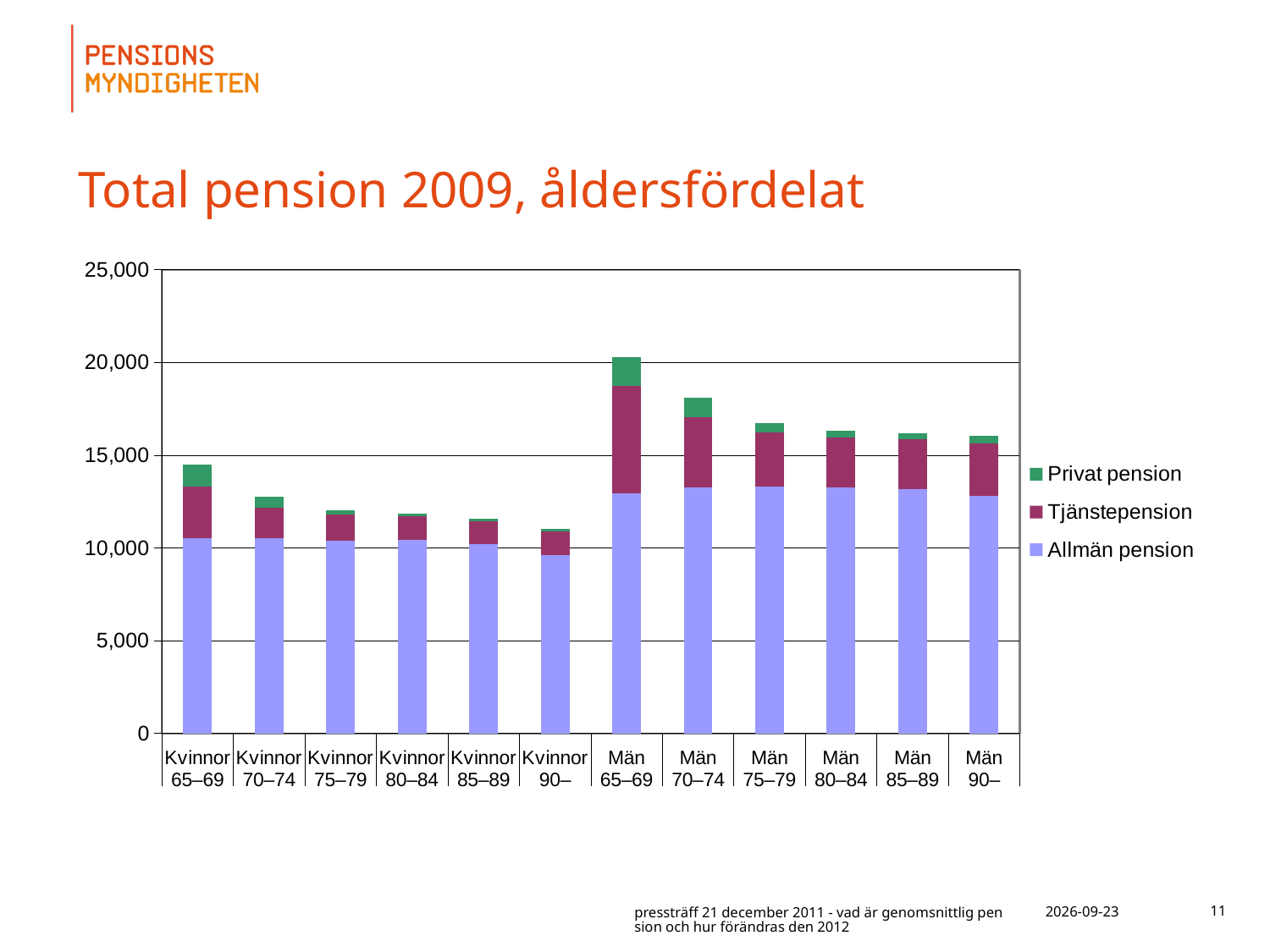
Is the total for Män 65–69 greater or less than 15,000? greater Which category has the highest total pension? Män 65–69 What kind of chart is shown on the slide? Stacked bar chart How many series does the legend list? 3 Do the total pension values for the Kvinnor groups rise or fall as the age group increases from 65–69 to 90–? fall Which legend entry is shown in green? Privat pension Is the total for Kvinnor 65–69 greater or less than 15,000? less Is the total for Kvinnor 90– greater or less than 15,000? less Which is larger, the total for Män 65–69 or the total for Kvinnor 65–69? Män 65–69 What is the title of the chart? Total pension 2009, åldersfördelat How many bars (categories) are plotted in the chart? 12 Which category has the lowest total pension? Kvinnor 90–